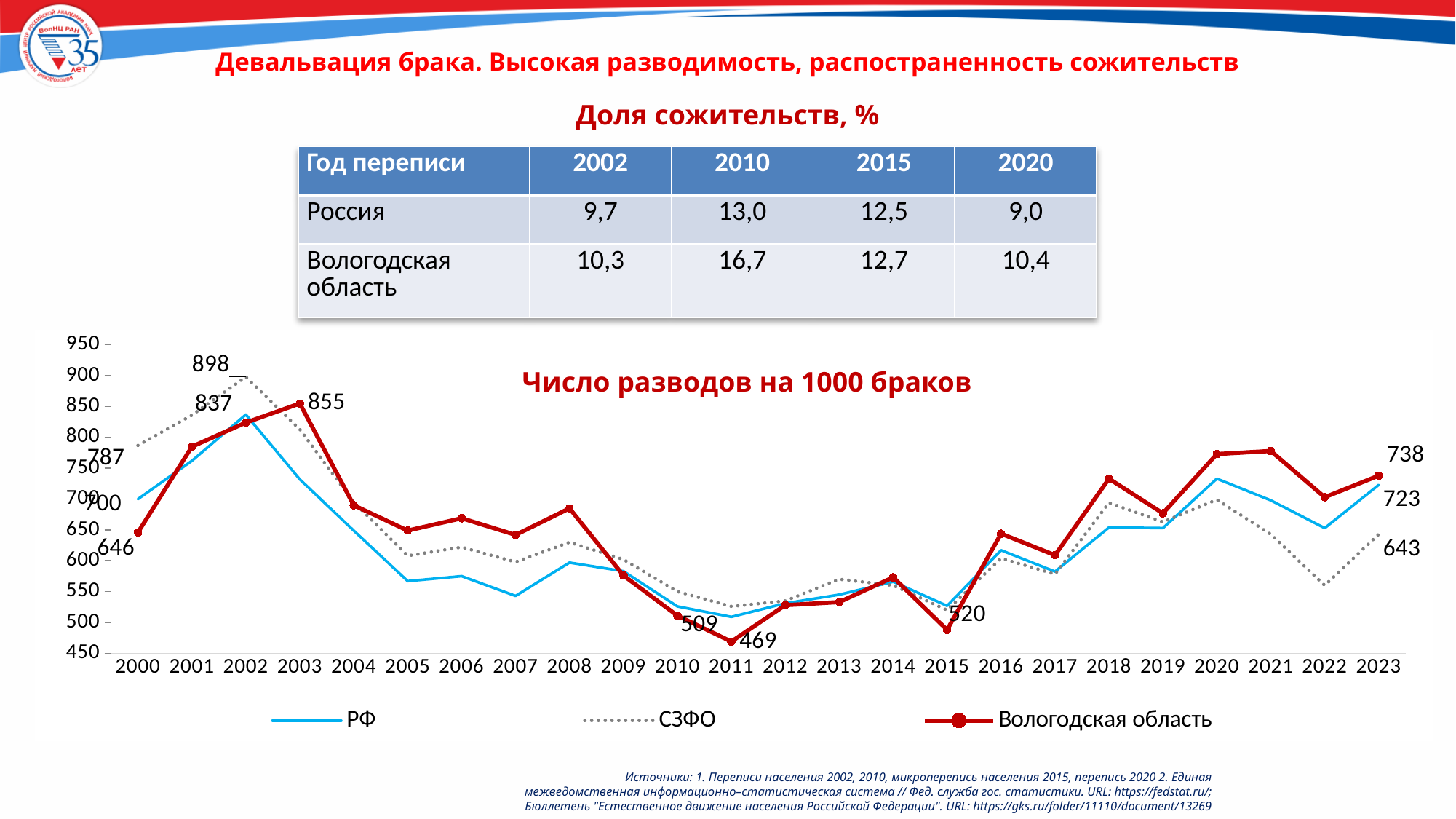
What kind of chart is shown on the slide? line chart What is the value for СЗФО in 2002? 898 What is the value for Вологодская область in 2023? 738 In which year is the value for Вологодская область the lowest? 2011 How many series does the legend of the chart list? 3 How many years are shown on the x axis of the chart? 24 What is the difference between the 2023 values for Вологодская область and РФ? 15 What is the value for Вологодская область in 2000? 646 What is the value for СЗФО in 2023? 643 What is the value for РФ in 2023? 723 Is the value for Вологодская область in 2015 greater or less than 500? less What is the value for Вологодская область in 2011? 469